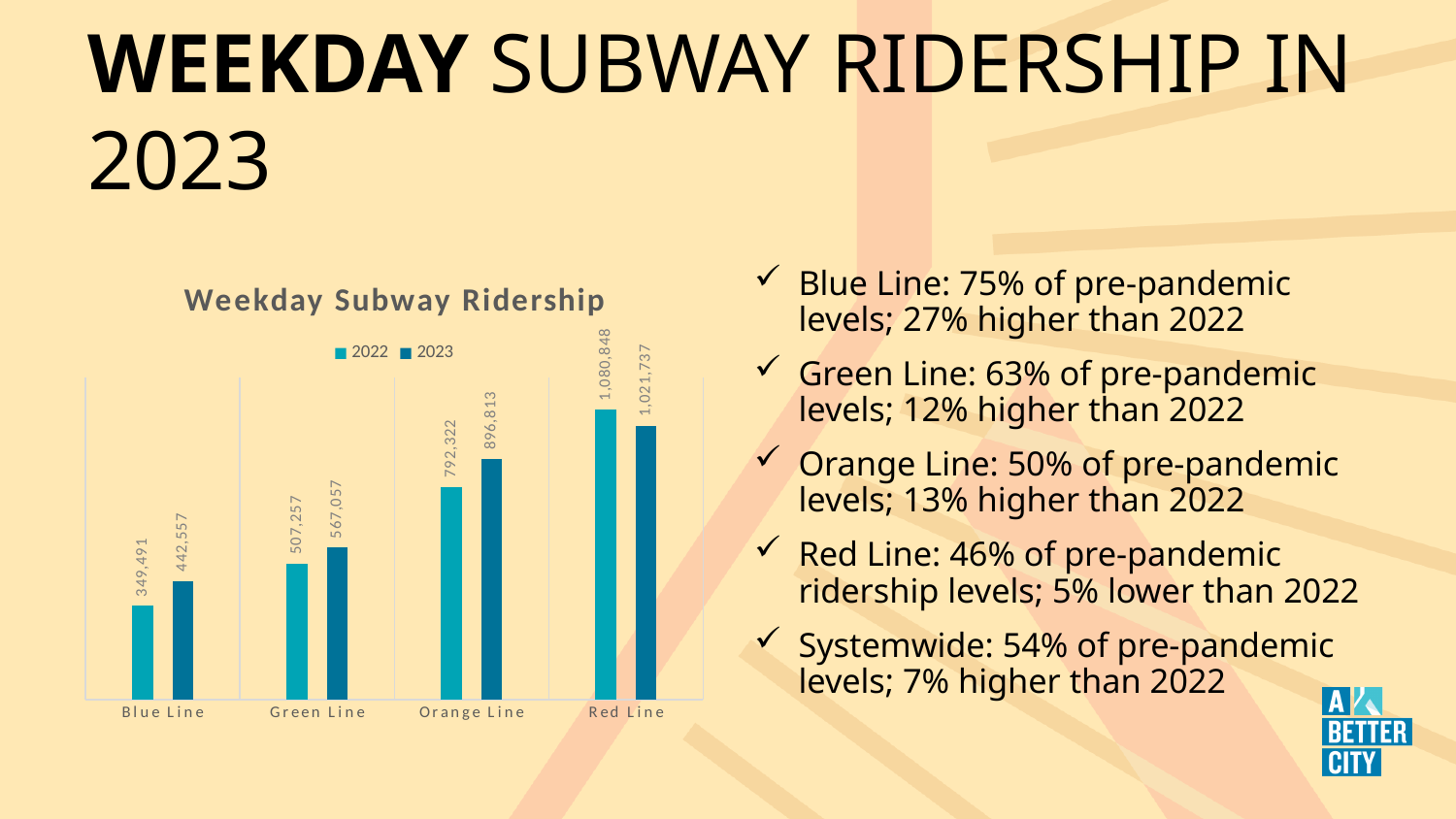
What was the 2022 weekday ridership for the Orange Line? 792,322 Which line had the highest weekday ridership in 2023? Red Line For the Red Line, which year had higher weekday ridership, 2022 or 2023? 2022 How many subway lines are shown on the x axis of the chart? 4 What was the 2022 weekday ridership for the Green Line? 507,257 How many series does the chart legend list? 2 Which line had the lowest weekday ridership in 2022? Blue Line What type of chart is used to show weekday subway ridership? Bar chart What was the 2023 weekday ridership for the Red Line? 1,021,737 What was the 2023 weekday ridership for the Blue Line? 442,557 By how much did Blue Line weekday ridership increase from 2022 to 2023? 93,066 What is the difference between the Red Line's 2022 and 2023 weekday ridership? 59,111